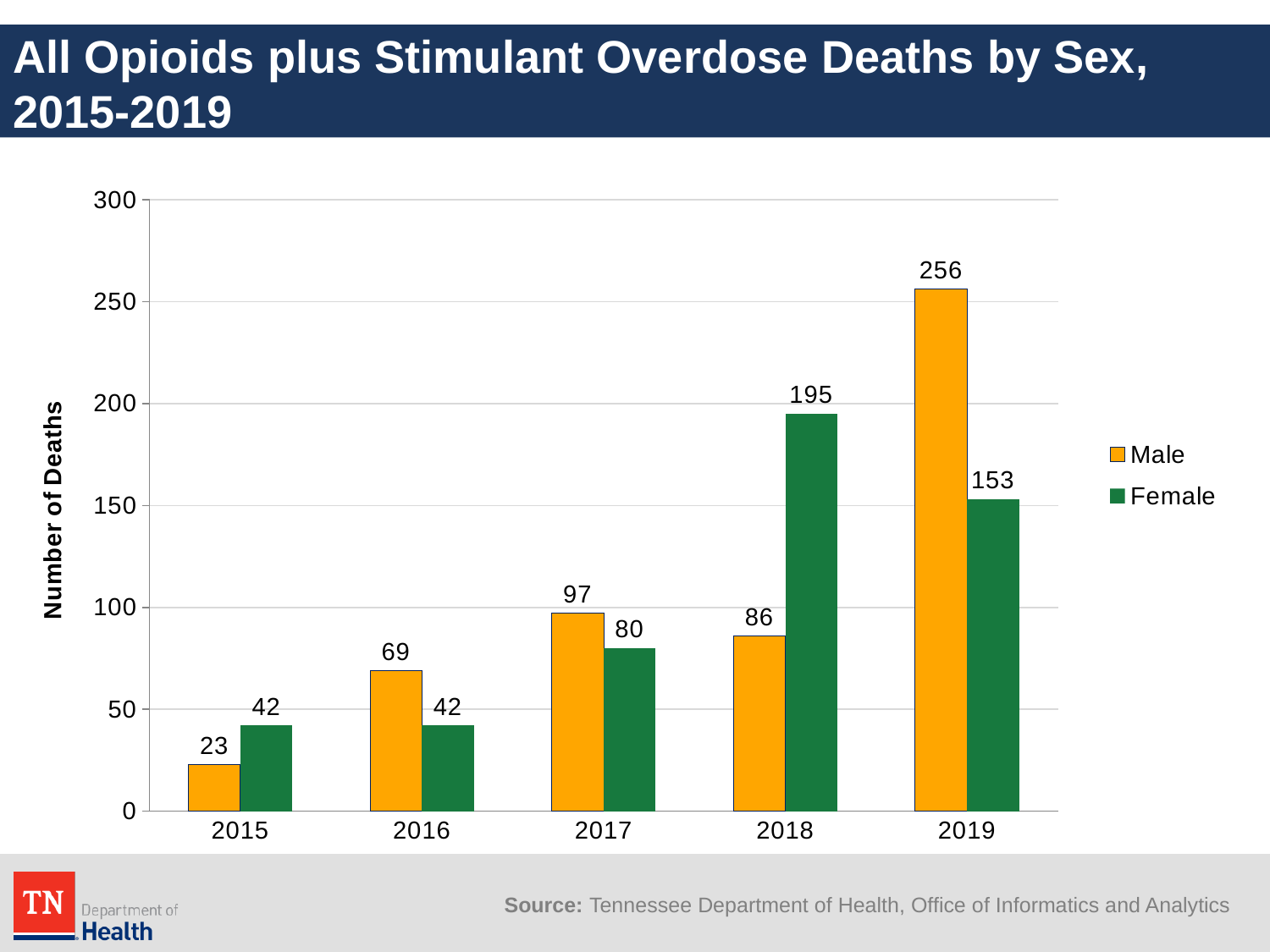
What is the number of Female deaths in 2018? 195 What kind of chart is shown on the slide? bar chart Is the number of Male deaths in 2019 greater or less than 250? greater How many years are shown on the x axis? 5 How many series does the legend list? 2 In 2017, which is larger, Male deaths or Female deaths? Male What is the number of Male deaths in 2015? 23 What is the label of the y axis? Number of Deaths What is the difference between Female and Male deaths in 2018? 109 Which year has the highest number of Female deaths? 2018 Which year has the lowest number of Male deaths? 2015 What is the number of Male deaths in 2019? 256